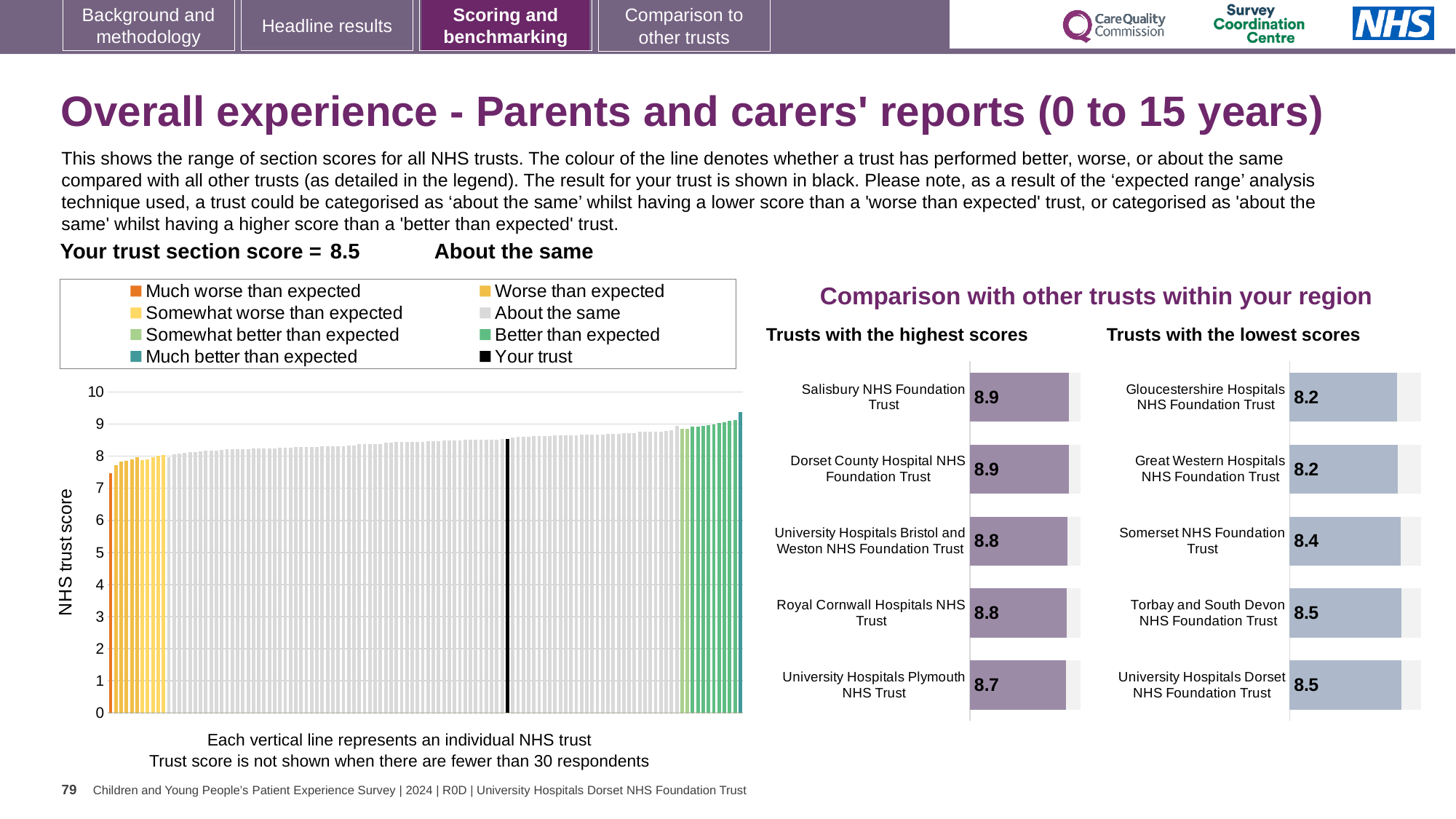
In the NHS trust score chart on the left, is the value for the leftmost (orange) bar greater or less than 8? less In the 'Trusts with the highest scores' chart, which trust has the lowest score? University Hospitals Plymouth NHS Trust In the 'Trusts with the lowest scores' chart, what is the difference between the scores of Torbay and South Devon NHS Foundation Trust and Gloucestershire Hospitals NHS Foundation Trust? 0.3 In the 'Trusts with the highest scores' chart, what is the score for University Hospitals Plymouth NHS Trust? 8.7 In the 'Trusts with the highest scores' chart, what is the difference between the scores of Salisbury NHS Foundation Trust and University Hospitals Plymouth NHS Trust? 0.2 In the 'Trusts with the lowest scores' chart, how many trusts are listed? 5 In the 'Trusts with the lowest scores' chart, what is the score for Somerset NHS Foundation Trust? 8.4 In the 'Trusts with the lowest scores' chart, which has the higher score: Somerset NHS Foundation Trust or Great Western Hospitals NHS Foundation Trust? Somerset NHS Foundation Trust In the 'Trusts with the highest scores' chart, what is the score for Salisbury NHS Foundation Trust? 8.9 In the 'Trusts with the lowest scores' chart, what is the score for Gloucestershire Hospitals NHS Foundation Trust? 8.2 How many entries does the legend of the NHS trust score chart on the left list? 8 In the NHS trust score chart on the left, is the value for the black 'Your trust' bar greater or less than 8? greater